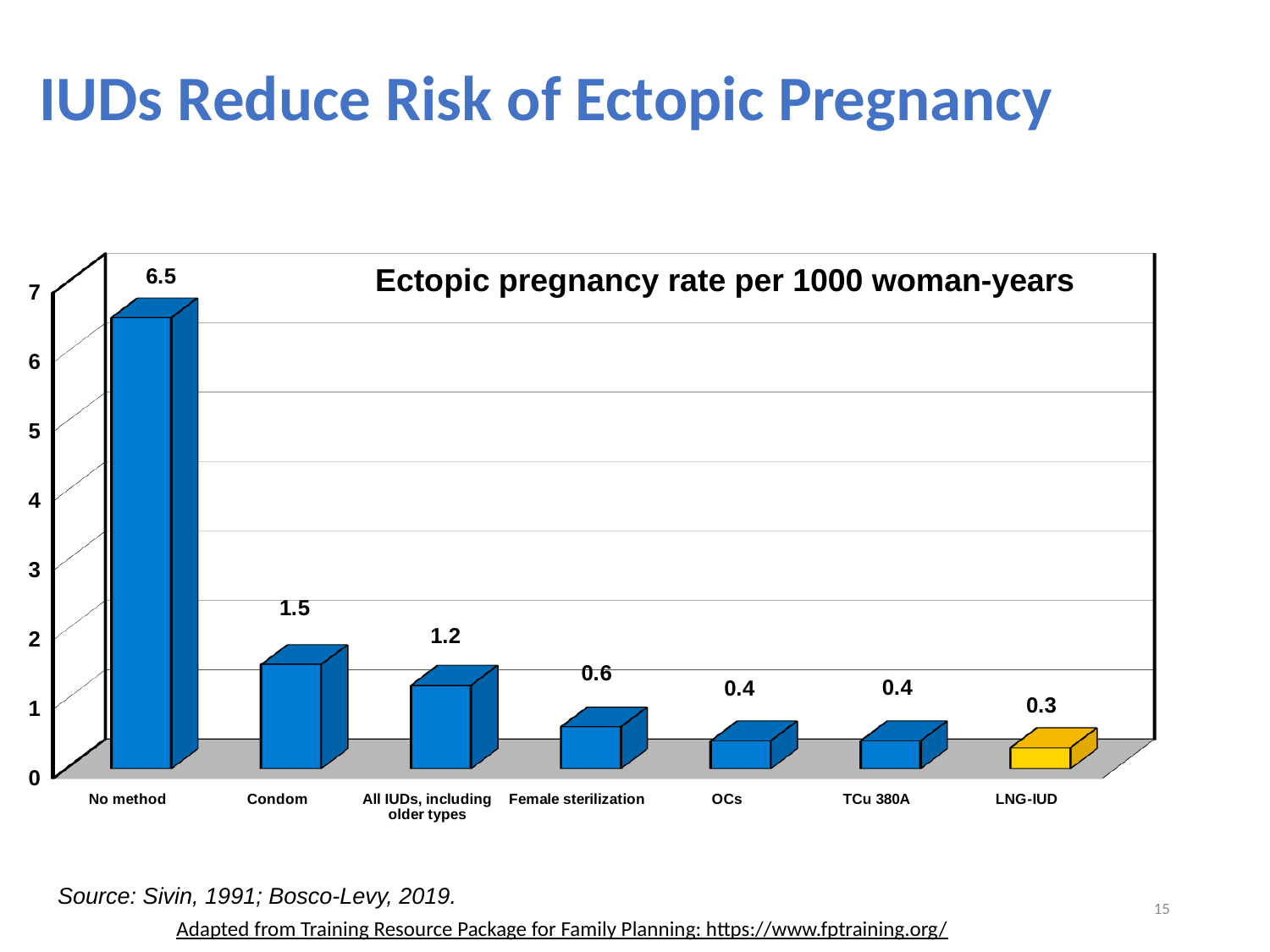
What is the ectopic pregnancy rate per 1000 woman-years for No method? 6.5 What is the ectopic pregnancy rate per 1000 woman-years for Condom? 1.5 Which has a higher ectopic pregnancy rate, Condom or Female sterilization? Condom What is the ectopic pregnancy rate per 1000 woman-years for LNG-IUD? 0.3 What is the ectopic pregnancy rate per 1000 woman-years for Female sterilization? 0.6 How many categories are shown on the chart? 7 Which category has the highest ectopic pregnancy rate? No method What kind of chart is shown on the slide? Bar chart What is the difference between the ectopic pregnancy rate for All IUDs, including older types and for TCu 380A? 0.8 What is the difference between the ectopic pregnancy rate for No method and for Condom? 5.0 Which category has the lowest ectopic pregnancy rate? LNG-IUD What is the title of the chart? Ectopic pregnancy rate per 1000 woman-years